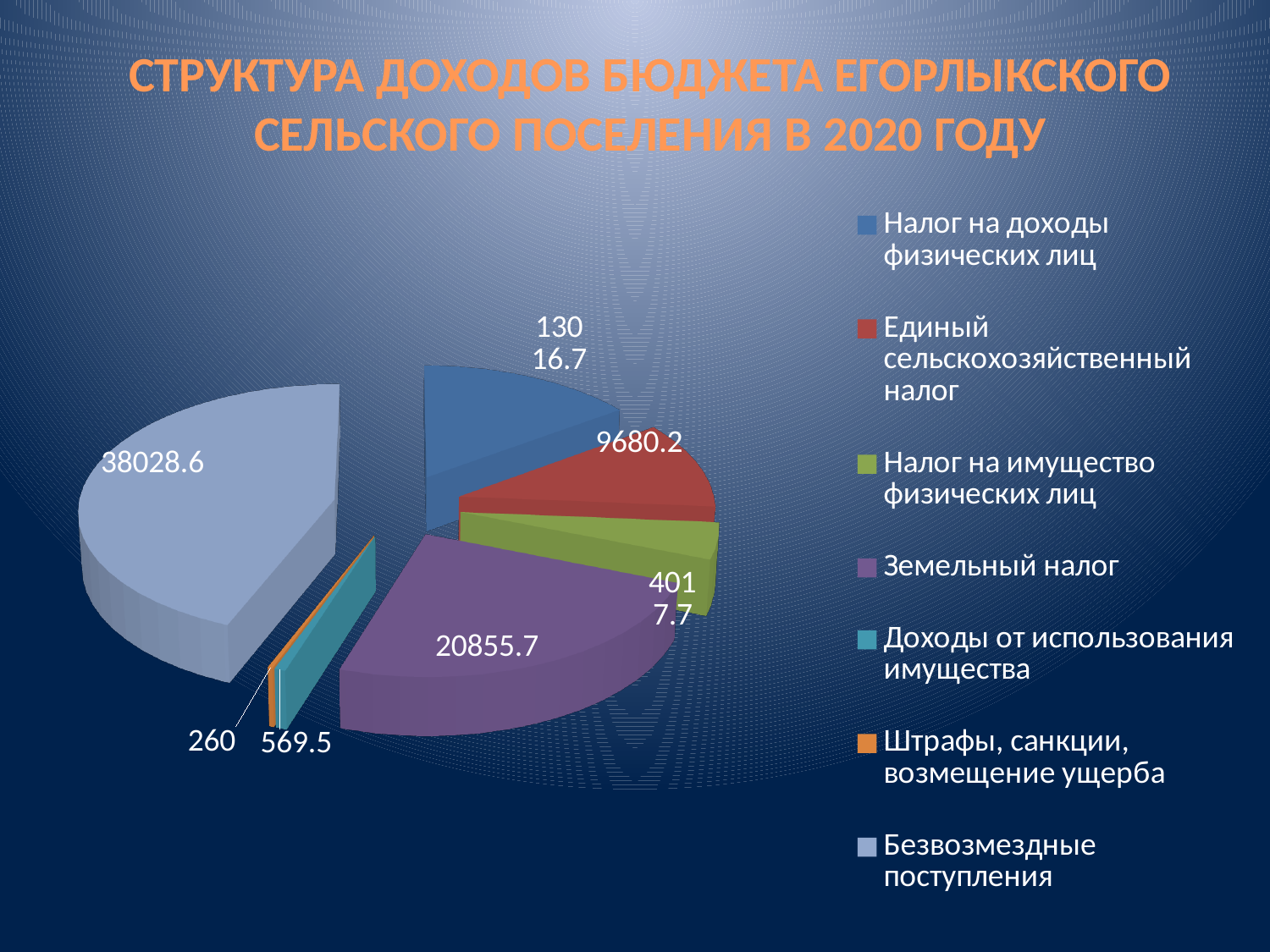
Which category has the smallest slice of the pie? Штрафы, санкции, возмещение ущерба What is the title of the slide? СТРУКТУРА ДОХОДОВ БЮДЖЕТА ЕГОРЛЫКСКОГО СЕЛЬСКОГО ПОСЕЛЕНИЯ В 2020 ГОДУ Which category has the largest slice of the pie? Безвозмездные поступления What is the value shown for Единый сельскохозяйственный налог? 9680.2 Which is larger: Земельный налог or Единый сельскохозяйственный налог? Земельный налог What is the value shown for Земельный налог? 20855.7 What is the value shown for Штрафы, санкции, возмещение ущерба? 260 What type of chart is shown on the slide? Pie chart How many categories does the legend of the pie chart list? 7 What is the value shown for Безвозмездные поступления? 38028.6 What is the value shown for Доходы от использования имущества? 569.5 What is the difference between the values for Безвозмездные поступления and Земельный налог? 17172.9